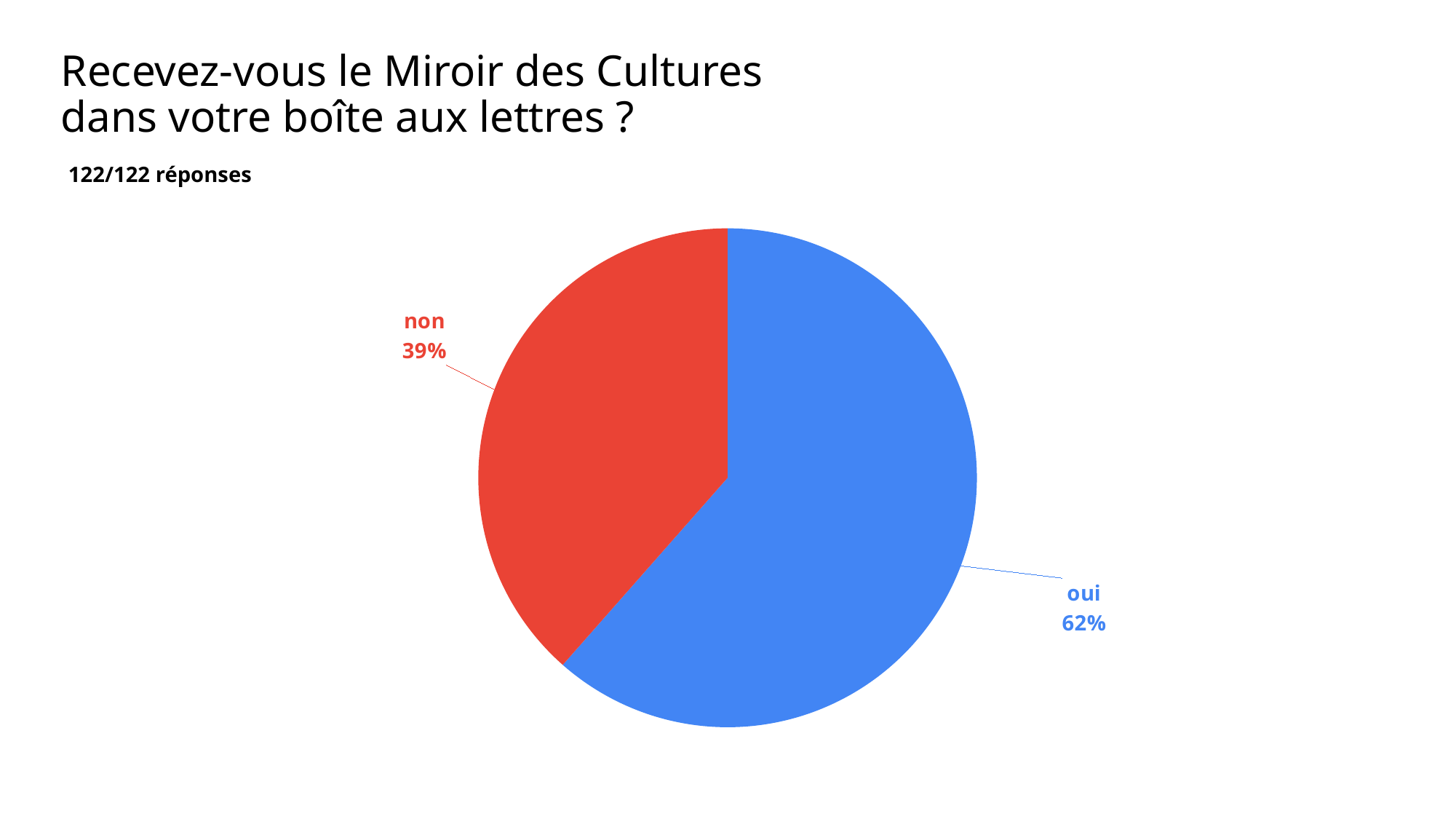
Which is larger, the 'oui' slice or the 'non' slice? oui What kind of chart is shown on the slide? pie chart Which slice is the smallest? non What is the difference in percentage points between the 'oui' and 'non' slices? 23 What share of responses is 'oui'? 62% What colour is the 'non' slice? red What share of responses is 'non'? 39% How many slices does the pie chart have? 2 How many responses does the slide say were collected? 122/122 réponses Is the share for 'oui' greater or less than 50%? greater Which slice is the largest? oui